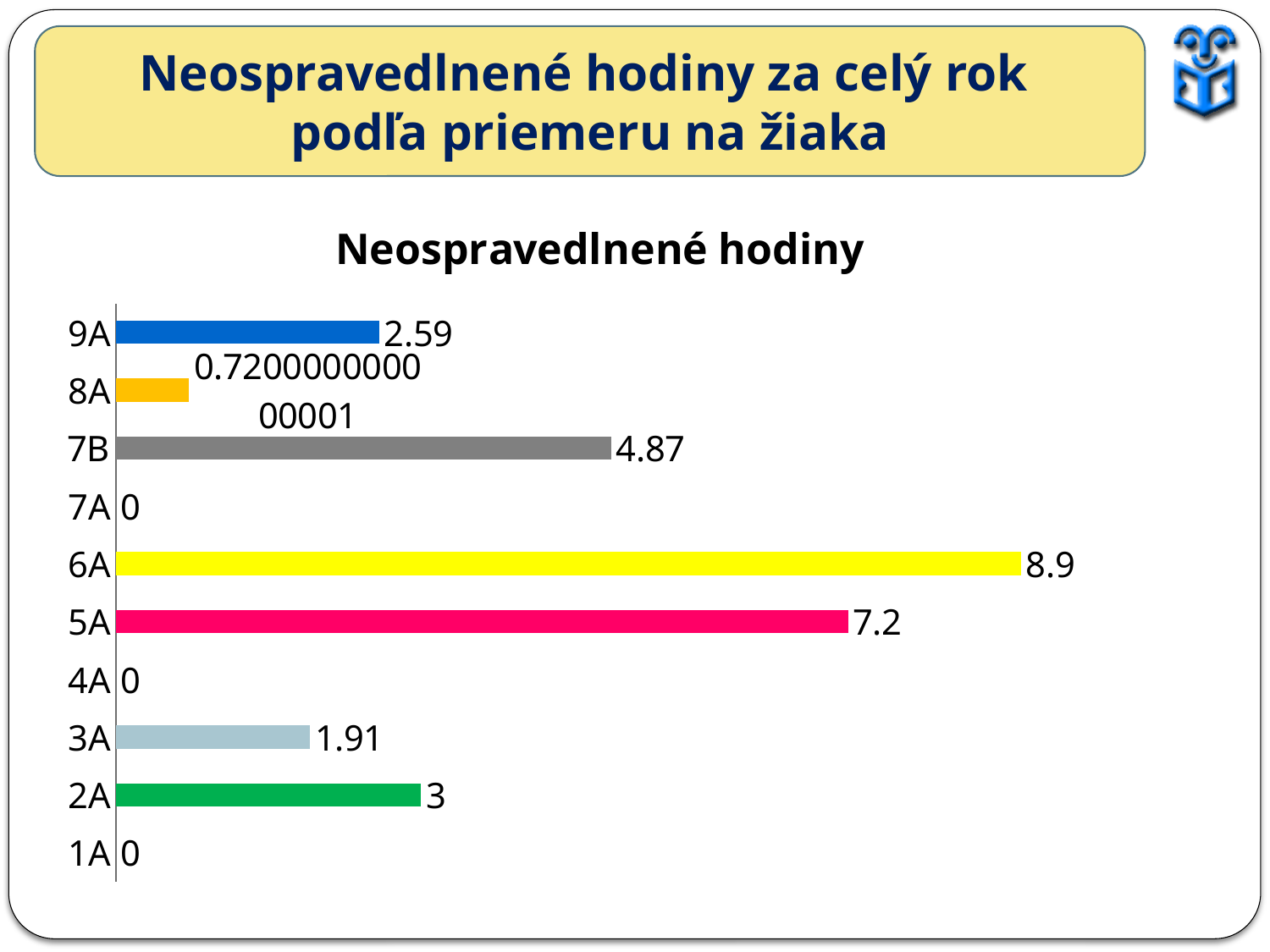
How many classes have a value of 0 in the chart? 3 How many classes (categories) are shown in the chart? 10 What is the value for class 7B? 4.87 What is the value for class 3A? 1.91 What is the title of the chart? Neospravedlnené hodiny What type of chart is shown on the slide? bar chart What is the difference between the values for 6A and 5A? 1.7 Which class has the larger value, 5A or 7B? 5A Which class has the highest value in the chart? 6A What is the value for class 2A? 3 What is the value for class 6A? 8.9 What is the value for class 9A? 2.59